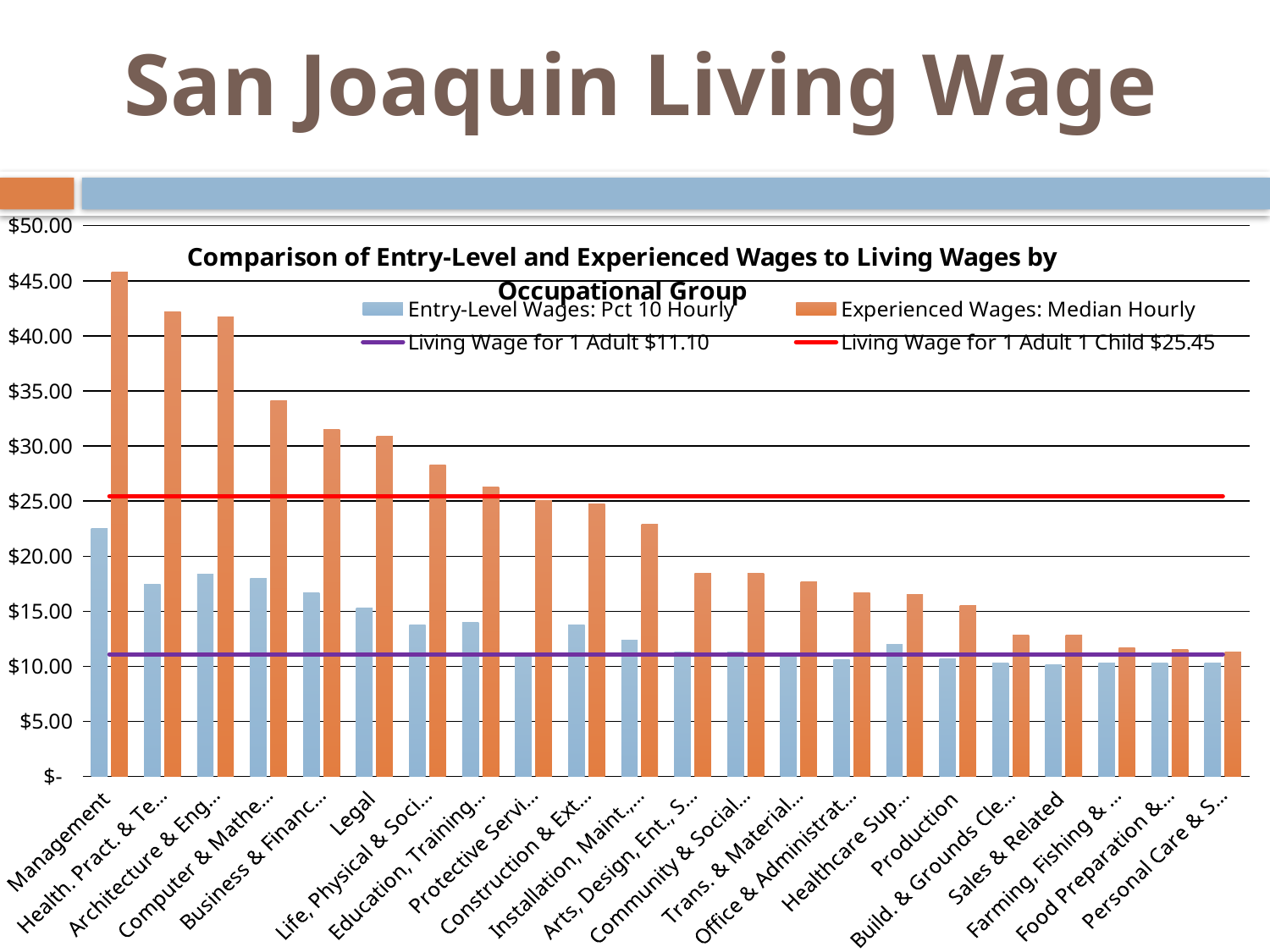
How many occupational groups are shown on the x axis? 22 Is the Experienced Wages: Median Hourly value for Sales & Related greater or less than $15.00? less What is the Living Wage for 1 Adult shown in the legend? $11.10 How many entries does the chart legend list? 4 Do the Experienced Wages: Median Hourly values generally rise or fall from left to right across the occupational groups? fall Is the Experienced Wages: Median Hourly value for Management greater or less than $40.00? greater Which occupational group has the highest Entry-Level Wages: Pct 10 Hourly? Management What is the title of the chart? Comparison of Entry-Level and Experienced Wages to Living Wages by Occupational Group Which occupational group has the highest Experienced Wages: Median Hourly? Management What is the Living Wage for 1 Adult 1 Child shown in the legend? $25.45 What kind of chart is shown on the slide? combination bar and line chart Which is larger: the Experienced Wages: Median Hourly for Architecture & Eng... or for Computer & Mathe...? Architecture & Eng...